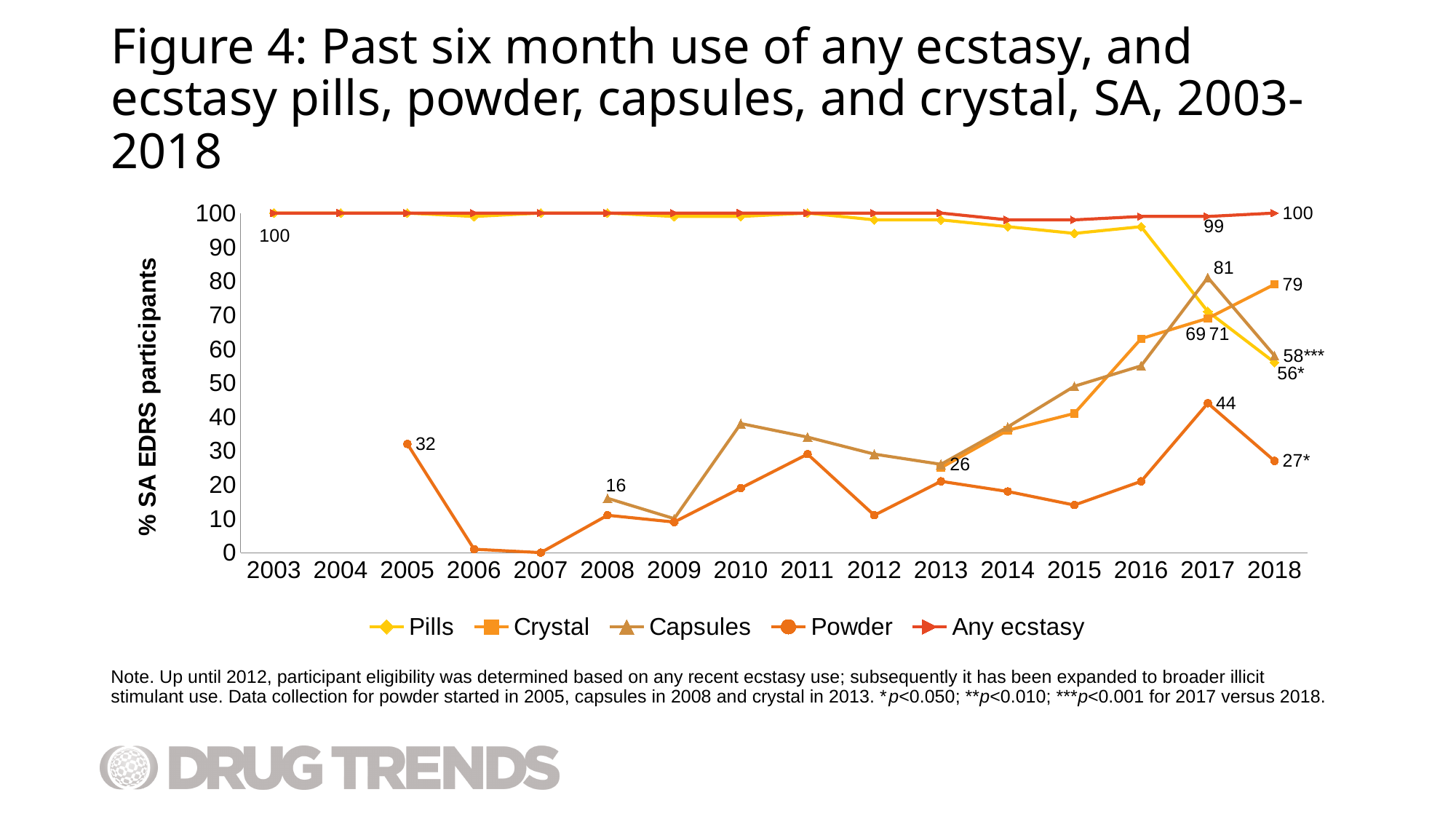
What is the value for Any ecstasy in 2017? 99 How many years are shown along the x axis? 16 In 2018, which is larger, the value for Crystal or the value for Powder? Crystal What is the difference between the Powder values in 2017 and 2018? 17 What is the value for Capsules in 2008? 16 What is the value for Crystal in 2018? 79 What is the value for Powder in 2005? 32 How many series does the legend list? 5 Is the value for Powder in 2012 greater or less than 20? less What kind of chart is shown on the slide? line chart Does the Crystal line rise or fall from 2013 to 2018? rise What is the value for Capsules in 2017? 81